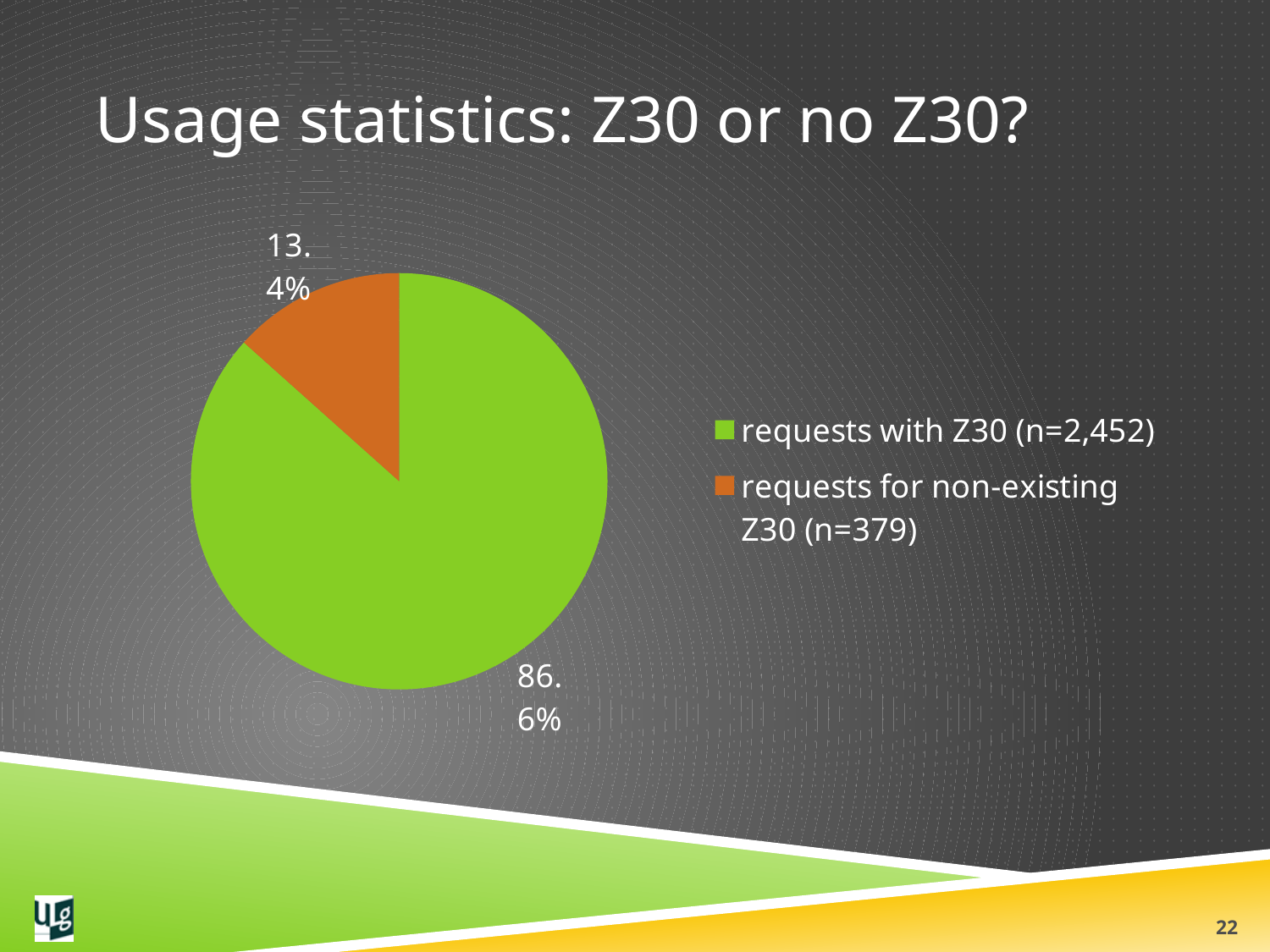
What is the difference between the number of requests with Z30 and the number of requests for non-existing Z30, using the n values in the legend? 2,073 According to the legend, how many requests with Z30 were there (n)? 2,452 What percentage of the pie is 'requests with Z30 (n=2,452)'? 86.6% What colour is the slice for 'requests with Z30'? green Which category has the smallest slice of the pie? requests for non-existing Z30 (n=379) What percentage of the pie is 'requests for non-existing Z30 (n=379)'? 13.4% What kind of chart is shown on the slide? pie chart What is the difference in percentage points between the 'requests with Z30' slice and the 'requests for non-existing Z30' slice? 73.2 percentage points Which category has the largest slice of the pie? requests with Z30 (n=2,452) According to the legend, how many requests for non-existing Z30 were there (n)? 379 Which is larger: the share of requests with Z30 or the share of requests for non-existing Z30? requests with Z30 How many slices does the pie chart have? 2